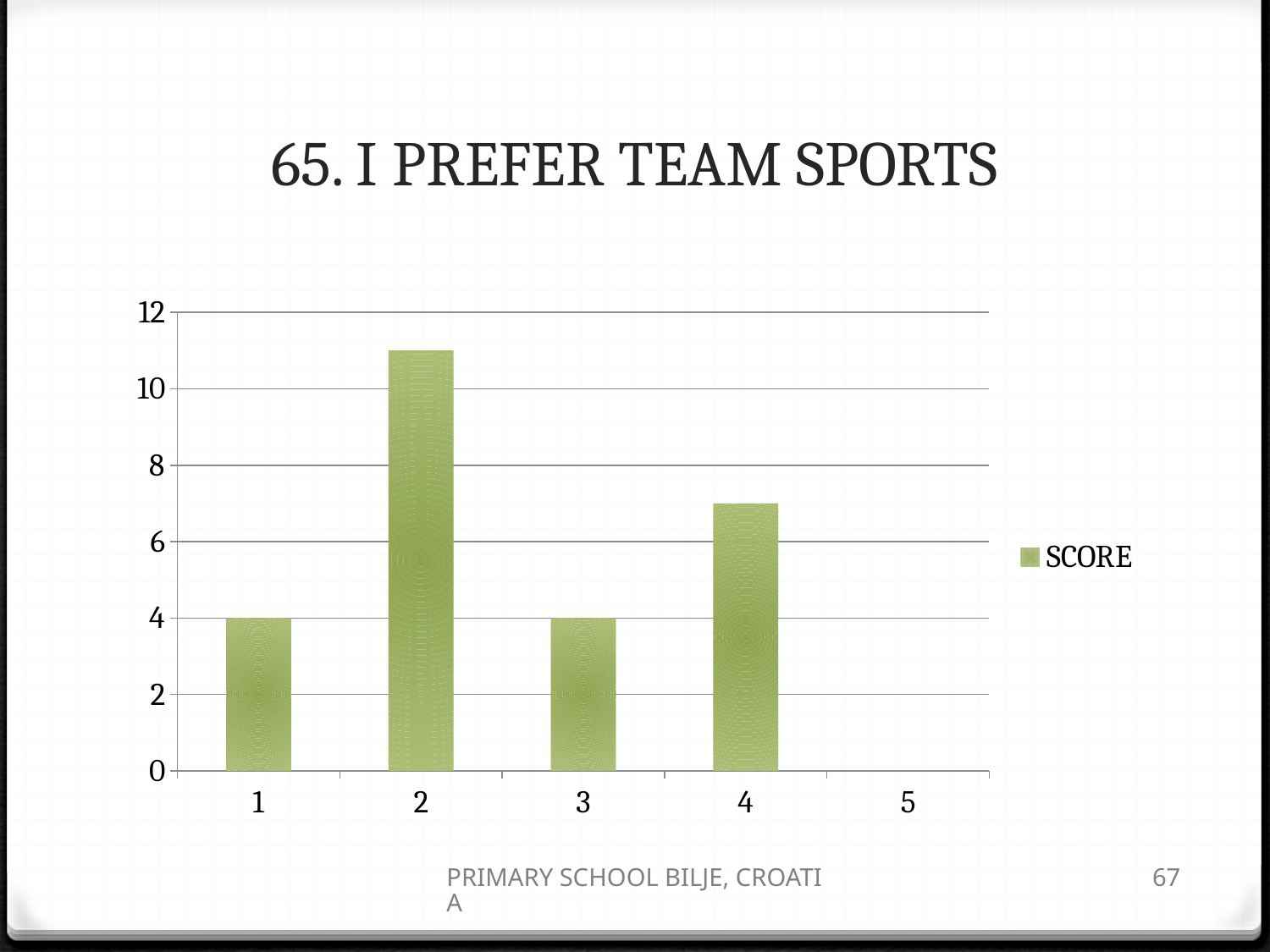
Is the value for category 4 greater or less than 8? less Which is larger, the value for category 2 or the value for category 4? 2 What kind of chart is shown on the slide? bar chart Which category has the lowest value? 5 What is the value for category 3? 4 Which category has the highest value? 2 How many categories are shown on the x axis? 5 What is the value for category 1? 4 Is the value for category 2 greater or less than 10? greater What is the value for category 5? 0 What is the difference between the values for category 1 and category 5? 4 How many series does the legend list? 1